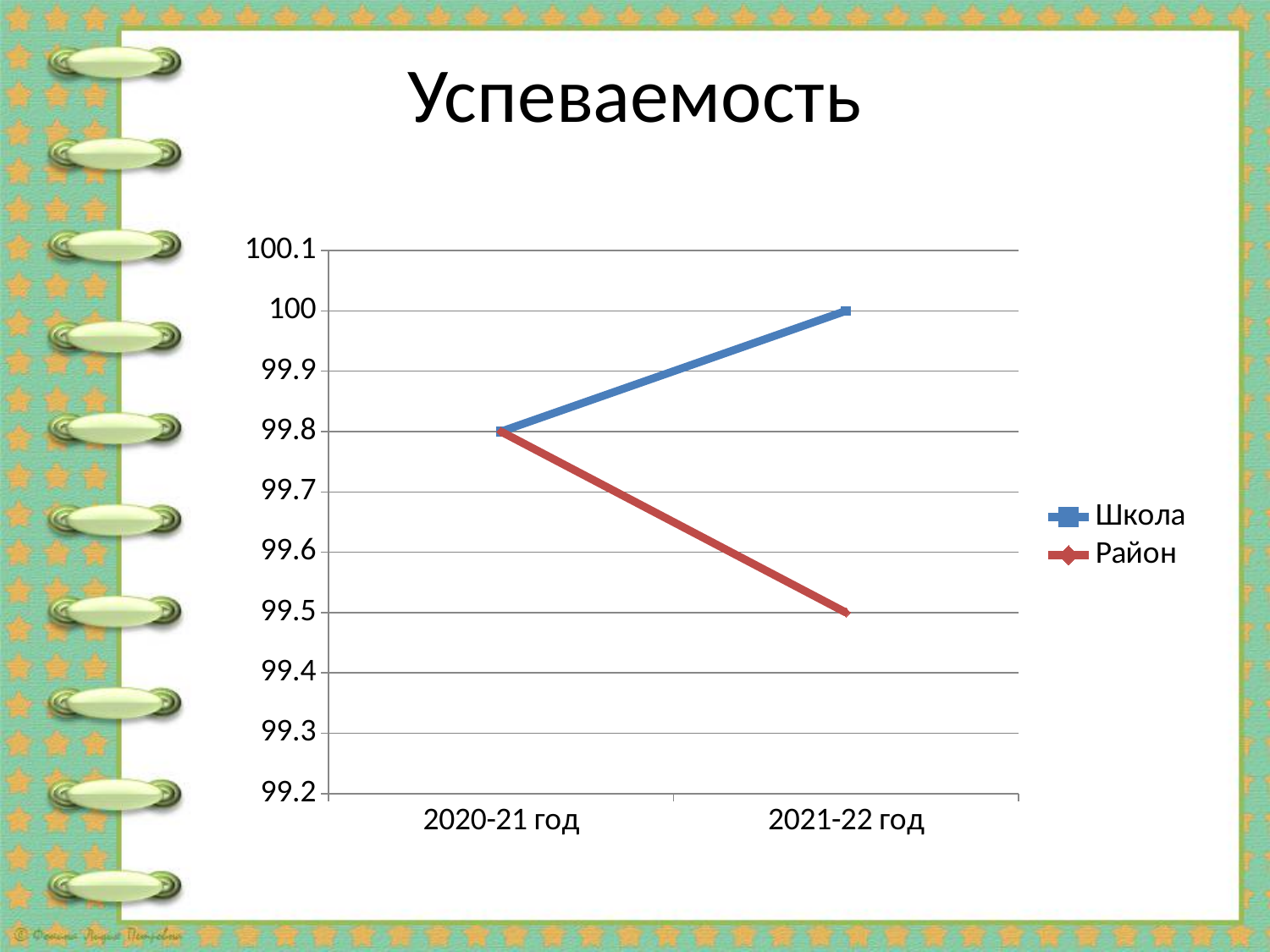
Does the Район series rise or fall from 2020-21 год to 2021-22 год? fall How many points are on the x axis of the chart? 2 Which series has the higher value in 2021-22 год, Школа or Район? Школа What is the value for Район in 2021-22 год? 99.5 What kind of chart is shown on the slide? line chart Does the Школа series rise or fall from 2020-21 год to 2021-22 год? rise How many series does the legend list? 2 What is the value for Школа in 2021-22 год? 100 What is the value for Школа in 2020-21 год? 99.8 What is the difference between the Школа and Район values in 2021-22 год? 0.5 What is the value for Район in 2020-21 год? 99.8 What is the title of the chart on the slide? Успеваемость